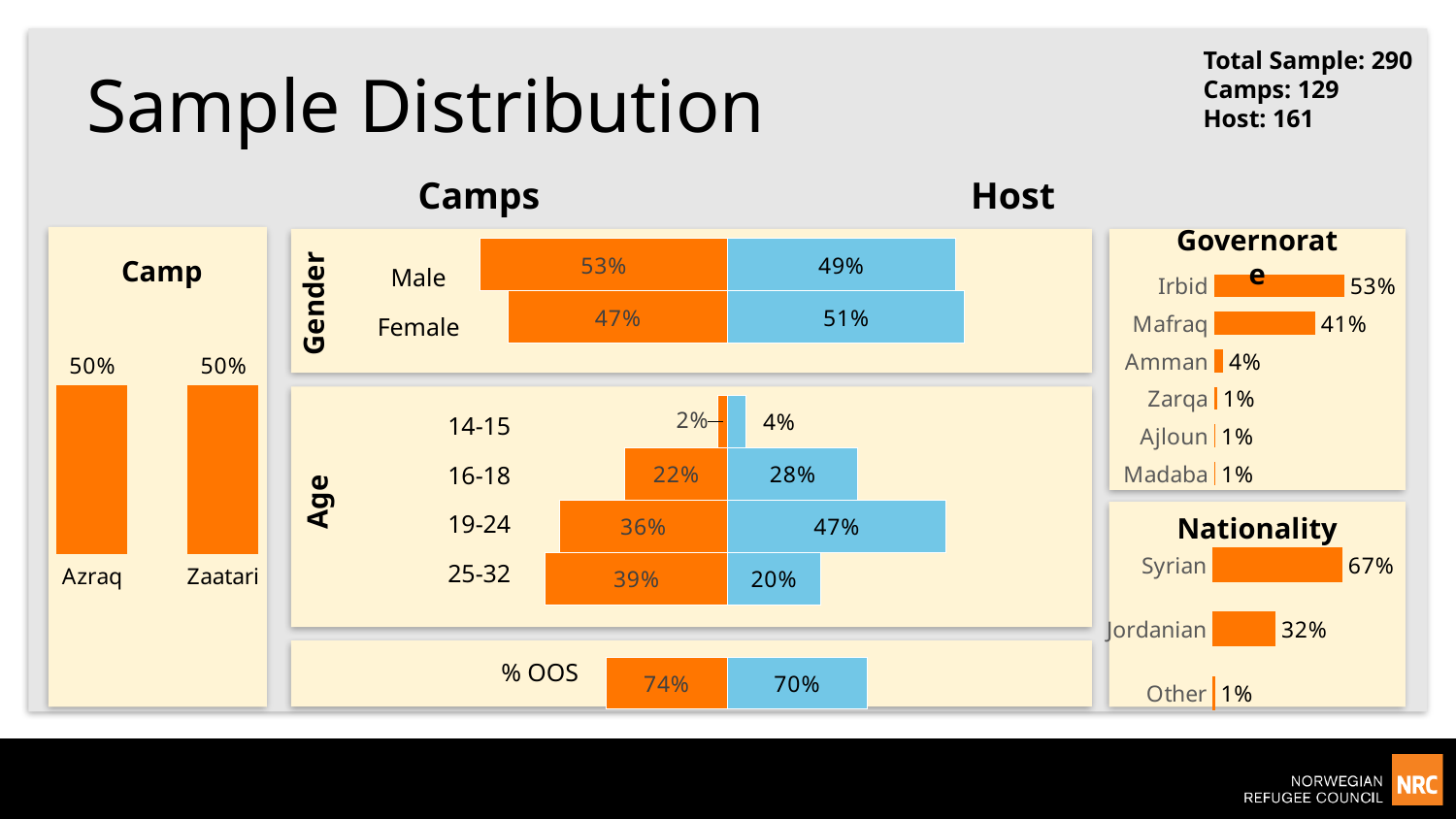
In the Age chart, what is the difference between the Host and Camps values for the 19-24 group? 11% In the Governorate chart, which governorate has the highest value? Irbid In the Nationality chart, what is the difference between the Syrian and Jordanian values? 35% In the Governorate chart, what is the value for Mafraq? 41% In the % OOS chart, what is the Camps value? 74% In the Age chart, which age group has the highest Host value? 19-24 In the Age chart, which age group has the lowest Camps value? 14-15 In the Gender chart, what is the Camps value for Male? 53% In the Age chart, which is larger for the 25-32 group, the Camps value or the Host value? Camps In the Gender chart, what is the Host value for Female? 51% How many governorates are listed in the Governorate chart? 6 In the Camp chart, what is the value for Azraq? 50%